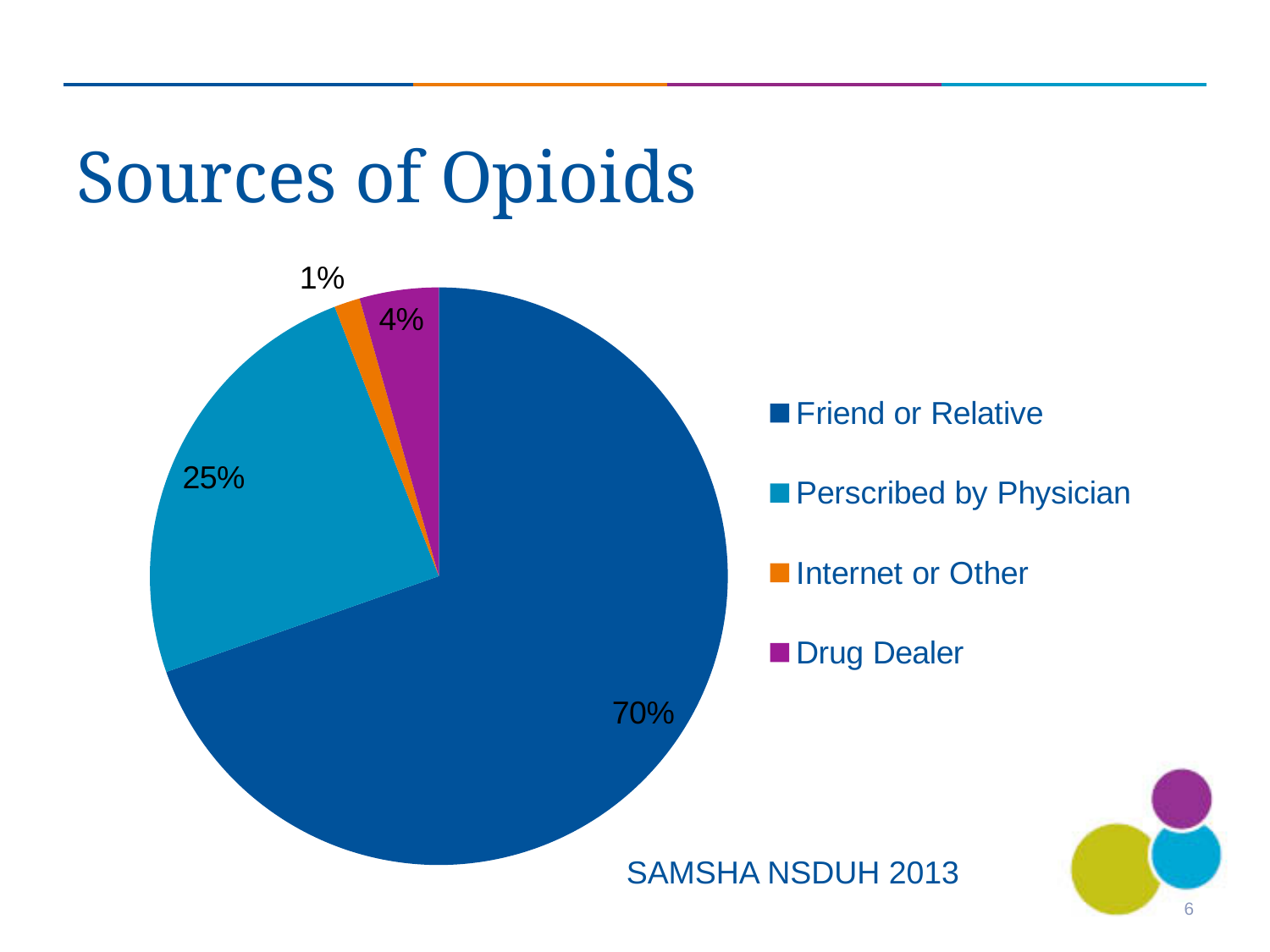
What is the difference in percentage points between Friend or Relative and Perscribed by Physician? 45 What percentage of opioids are Perscribed by Physician? 25% What percentage of opioids come from a Friend or Relative? 70% Which source accounts for the largest share of opioids? Friend or Relative What type of chart is shown on the slide? pie chart How many categories does the pie chart show? 4 Which is larger, the share for Drug Dealer or the share for Internet or Other? Drug Dealer What is the title of the slide containing the pie chart? Sources of Opioids What colour is the slice for Internet or Other? orange What percentage of opioids come from Internet or Other? 1% Which source accounts for the smallest share of opioids? Internet or Other What percentage of opioids come from a Drug Dealer? 4%